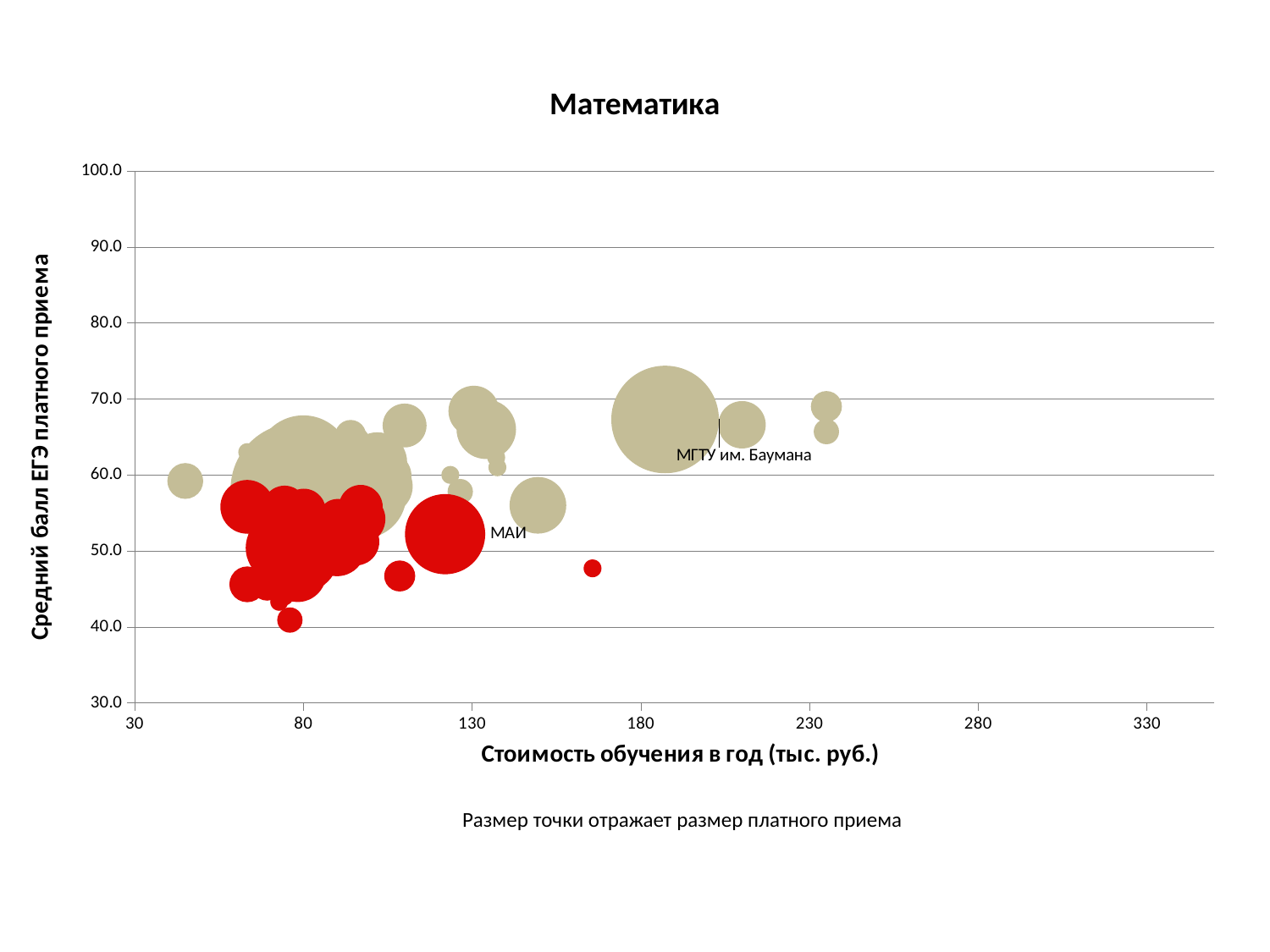
What is the label of the horizontal axis? Стоимость обучения в год (тыс. руб.) Is the tuition cost (x value) for МГТУ им. Баумана greater or less than 130? greater What is the title of the chart? Математика Is the average exam score (y value) for МАИ greater or less than 60? less Which has the higher average exam score, МАИ or МГТУ им. Баумана? МГТУ им. Баумана What kind of chart is shown on the slide? Bubble chart Which has the higher tuition cost per year, МАИ or МГТУ им. Баумана? МГТУ им. Баумана Is the average exam score (y value) for МГТУ им. Баумана greater or less than 60? greater What is the highest value shown on the vertical axis? 100.0